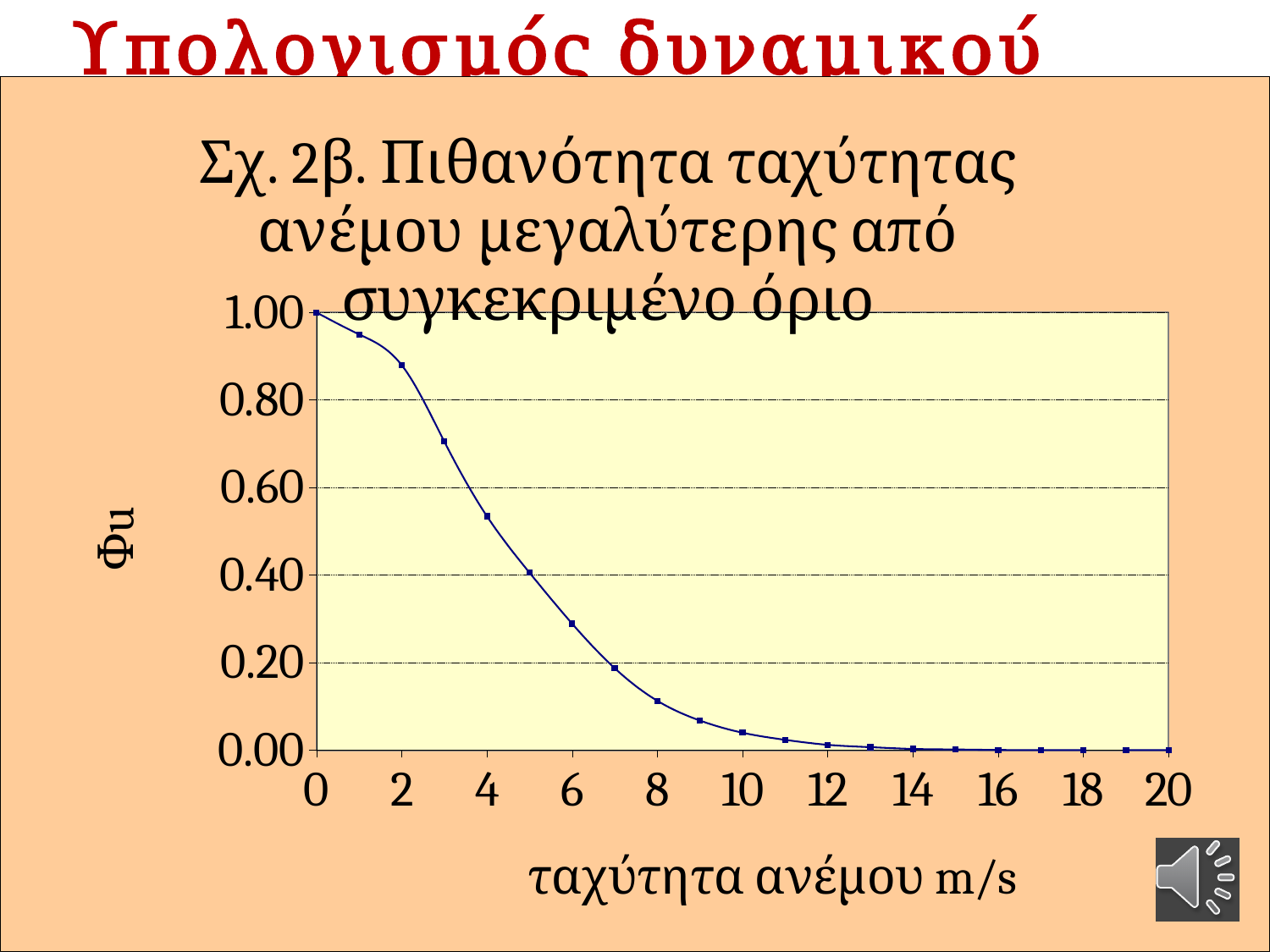
Is the value of Φu at 6 m/s greater or less than 0.40? less How many data points are plotted on the line? 21 Does Φu rise or fall as wind speed increases along the x axis? fall Is the value of Φu at 8 m/s greater or less than 0.20? less Which has the larger Φu value: a wind speed of 2 m/s or 6 m/s? 2 m/s What is the label of the x axis? ταχύτητα ανέμου m/s What kind of chart is shown on the slide? line chart Is the value of Φu at 4 m/s greater or less than 0.60? less What is the label of the y axis? Φu What is the value of Φu at a wind speed of 0 m/s? 1.00 At which wind speed is Φu highest? 0